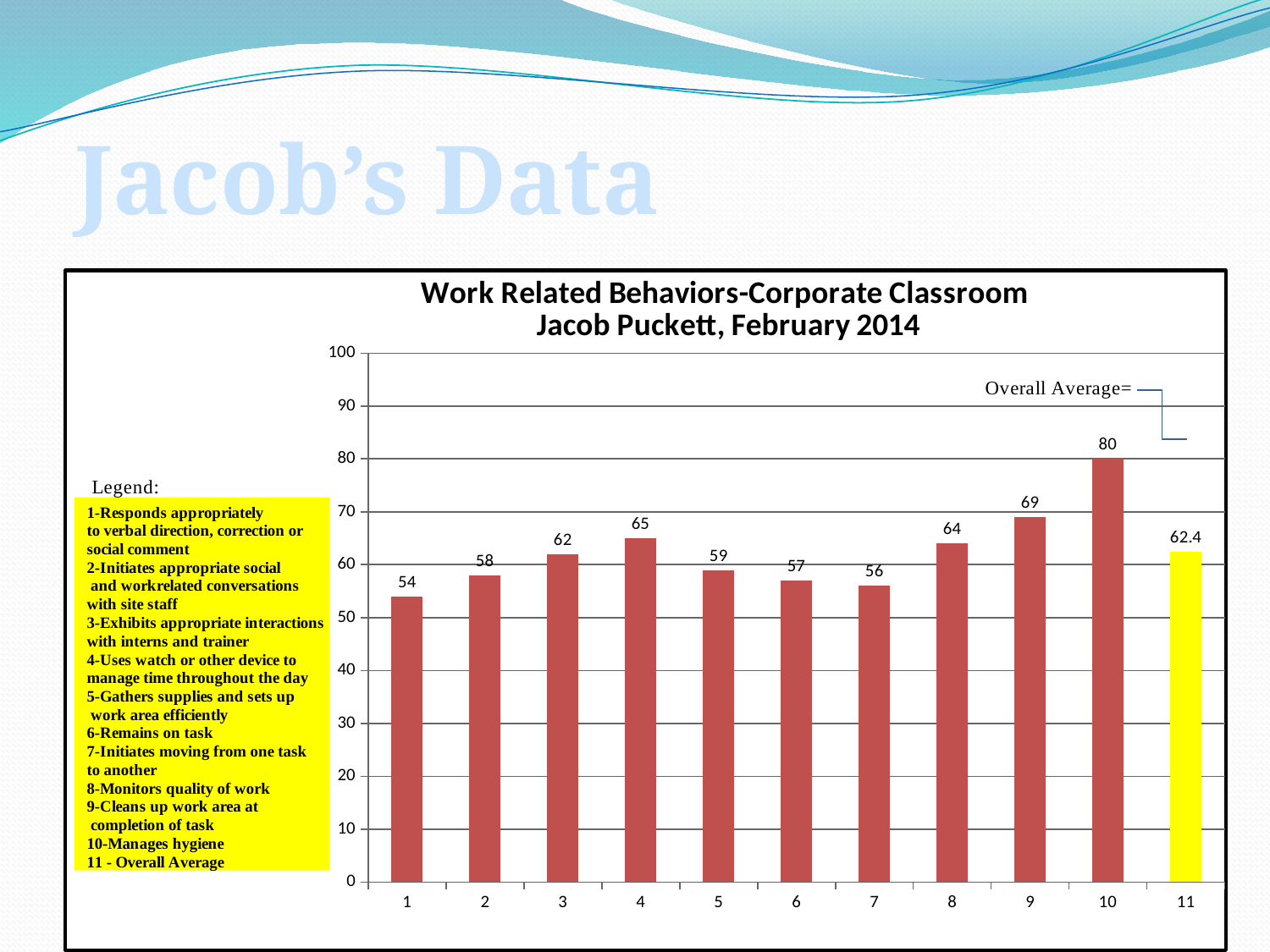
What is the title of the chart? Work Related Behaviors-Corporate Classroom Jacob Puckett, February 2014 What is the value for category 10? 80 What is the difference between the values for category 10 and category 1? 26 Which category has the lowest value? 1 Which category has the highest value? 10 What colour is the bar for category 11? Yellow What is the value for category 11, the Overall Average? 62.4 What is the value for category 1? 54 How many bars are plotted on the chart? 11 What kind of chart is shown? Bar chart Which is larger, the value for category 4 or the value for category 8? Category 4 Is the value for category 9 greater or less than 60? greater